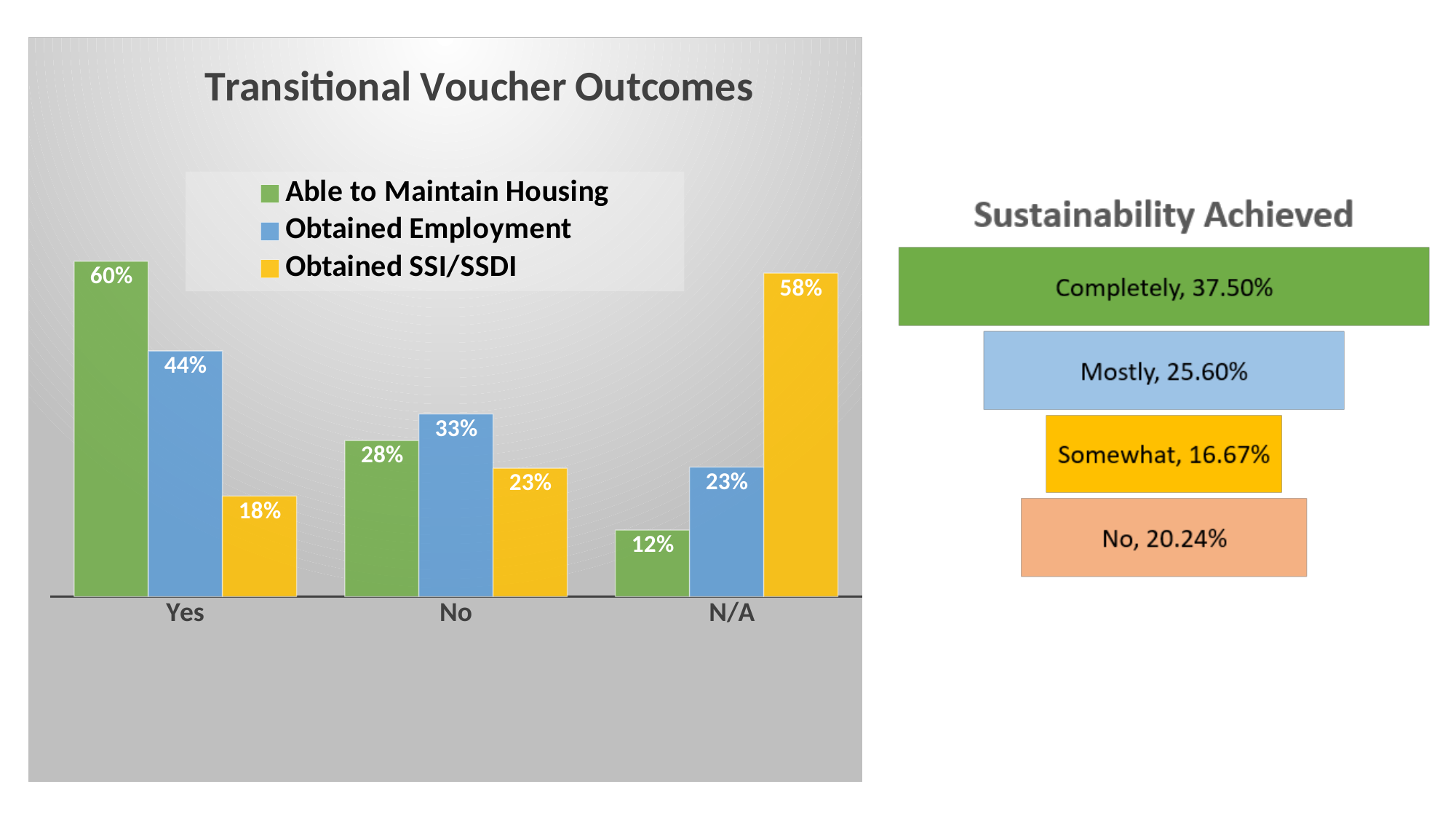
How many series does the legend of the Transitional Voucher Outcomes chart list? 3 In the Sustainability Achieved chart, which category has the highest value? Completely In the Transitional Voucher Outcomes chart, what is the value for Obtained SSI/SSDI in the N/A category? 58% In the Transitional Voucher Outcomes chart, what is the difference between Able to Maintain Housing and Obtained SSI/SSDI in the Yes category? 42% In the Transitional Voucher Outcomes chart, what is the value for Obtained Employment in the No category? 33% In the Transitional Voucher Outcomes chart, which category has the highest value for Obtained Employment? Yes How many categories are shown on the x axis of the Transitional Voucher Outcomes chart? 3 In the Transitional Voucher Outcomes chart, what is the value for Able to Maintain Housing in the Yes category? 60% In the Sustainability Achieved chart, what is the value for Mostly? 25.60% In the Transitional Voucher Outcomes chart, which is larger in the No category: Obtained Employment or Obtained SSI/SSDI? Obtained Employment What kind of chart is the Transitional Voucher Outcomes chart? Bar chart In the Transitional Voucher Outcomes chart, which category has the lowest value for Able to Maintain Housing? N/A